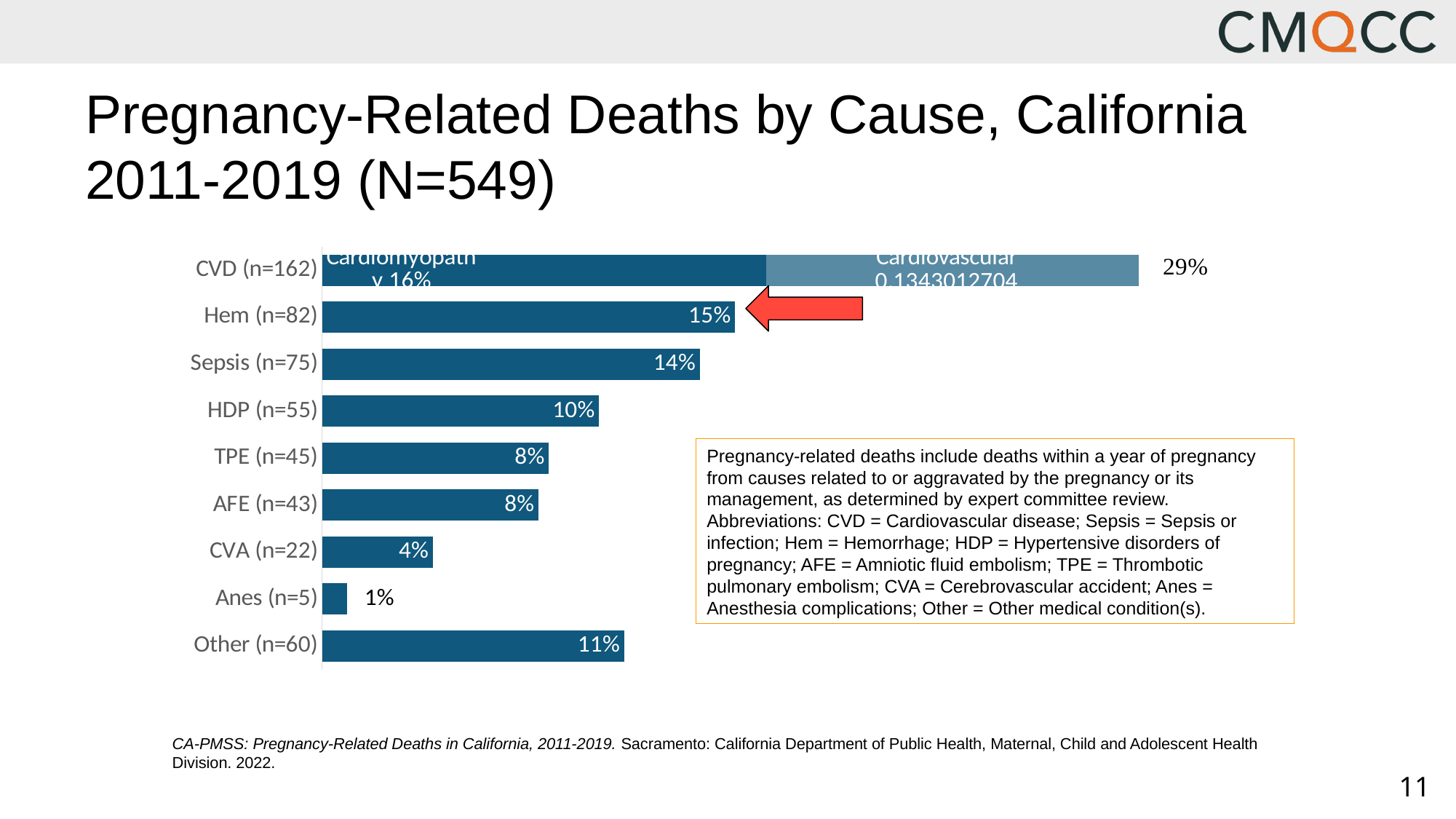
How many cause categories are shown in the chart? 9 What is the value for Hem (n=82)? 15% What is the title of the slide? Pregnancy-Related Deaths by Cause, California 2011-2019 (N=549) What is the value for Sepsis (n=75)? 14% What is the value for Other (n=60)? 11% What is the value for HDP (n=55)? 10% Which is larger, the value for Sepsis (n=75) or the value for Other (n=60)? Sepsis (n=75) Which cause has the lowest share of pregnancy-related deaths? Anes (n=5) What is the difference between the values for Hem (n=82) and CVA (n=22)? 11% What is the value for Anes (n=5)? 1% Which cause has the highest share of pregnancy-related deaths? CVD (n=162) What kind of chart is shown on the slide? bar chart